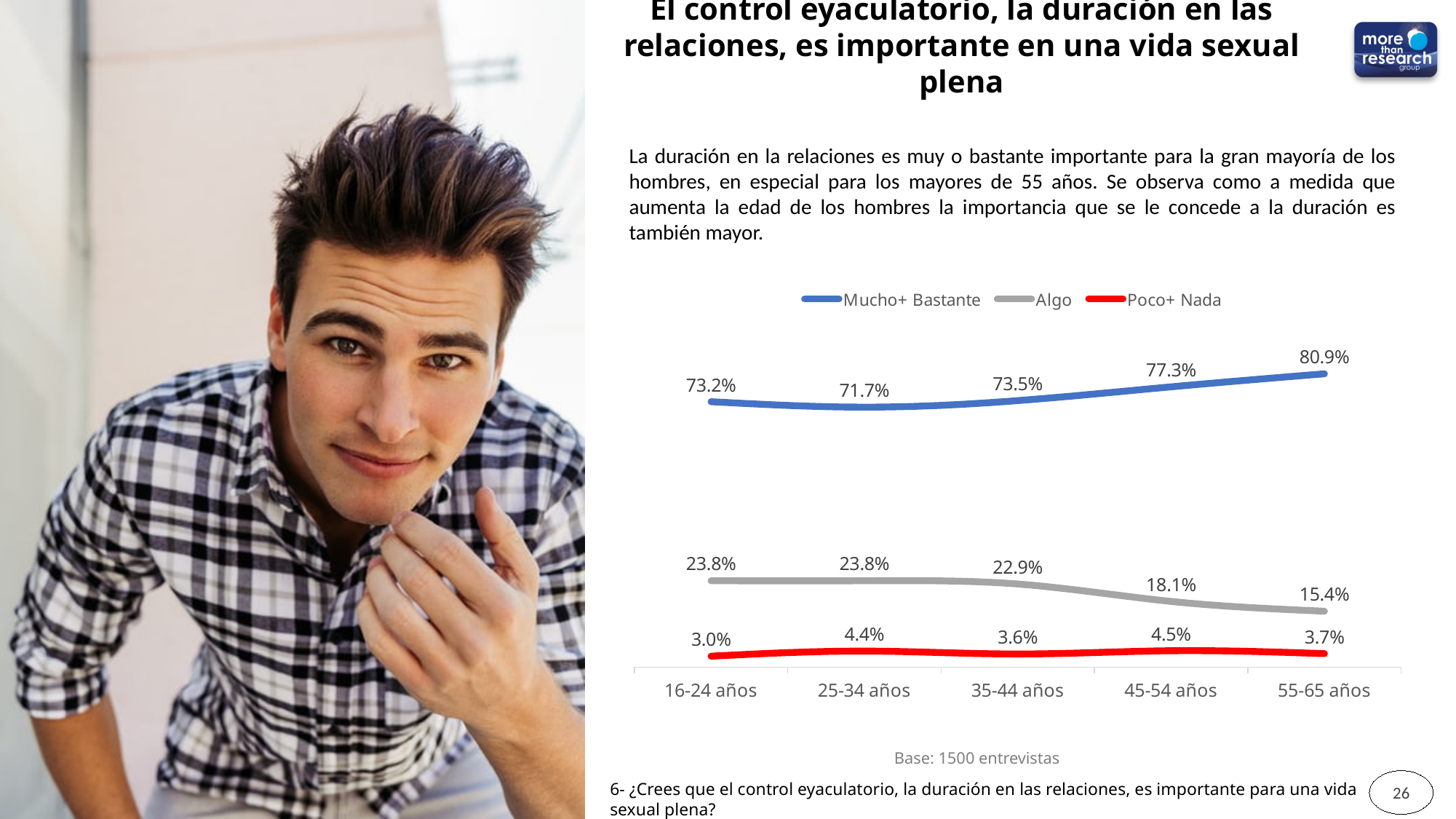
What is the value for Algo in the 35-44 años group? 22.9% How many age groups are shown on the x axis? 5 Does the Algo series rise or fall from 35-44 años to 55-65 años? Fall What is the value for Mucho+ Bastante in the 55-65 años group? 80.9% Which age group has the highest value for Mucho+ Bastante? 55-65 años Which is larger: the Poco+ Nada value for 25-34 años or for 35-44 años? 25-34 años What is the value for Poco+ Nada in the 16-24 años group? 3.0% What kind of chart is shown on the slide? Line chart How many series does the legend list? 3 Which age group has the lowest value for Algo? 55-65 años What is the difference between the Mucho+ Bastante values for 55-65 años and 16-24 años? 7.7% Which age group has the lowest value for Mucho+ Bastante? 25-34 años